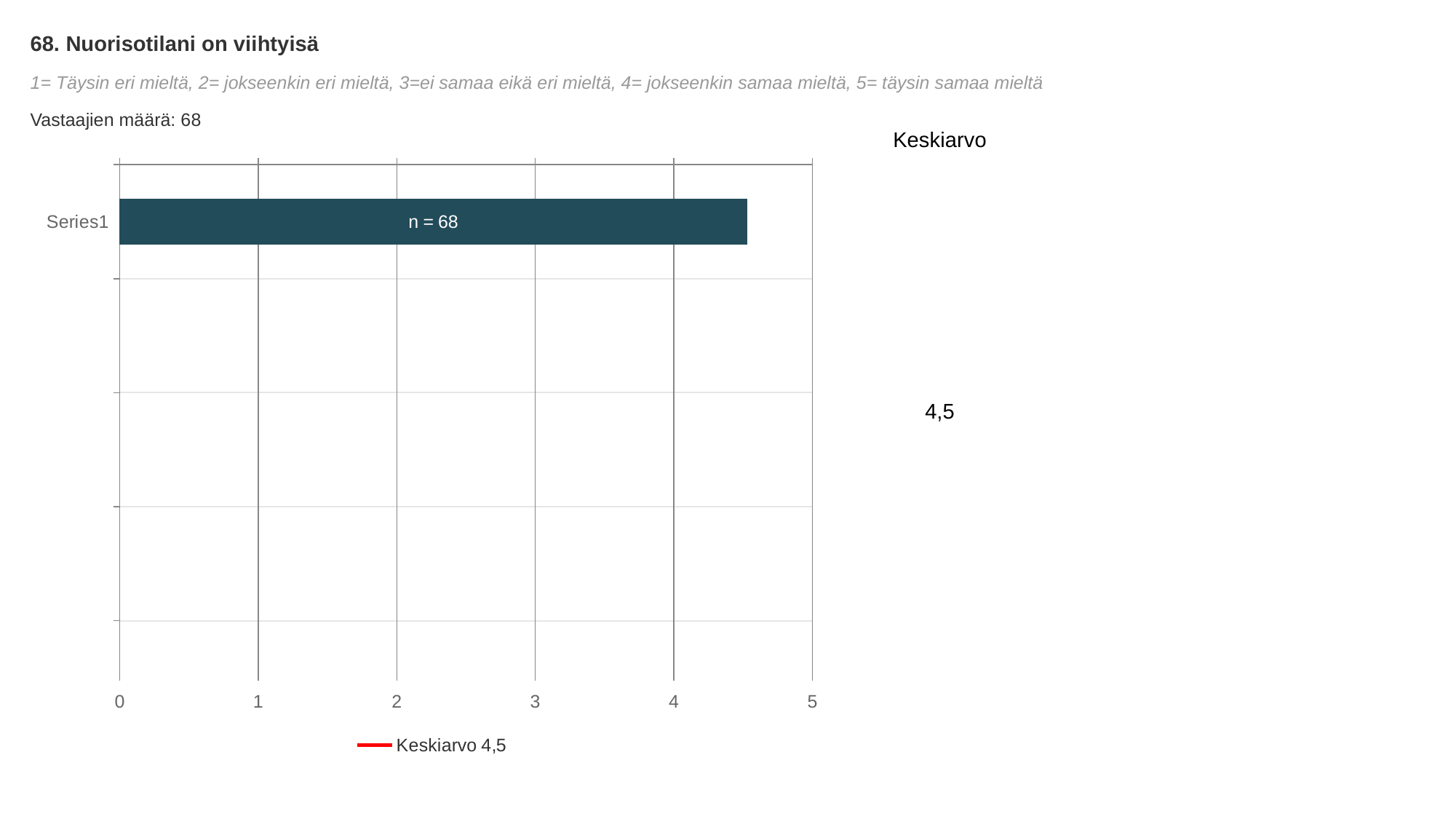
What is the Keskiarvo (mean) value shown on the slide? 4,5 How many bars are plotted in the chart? 1 Is the value of the Series1 bar greater or less than 5? less Is the value of the Series1 bar greater or less than 3? greater What is the label of the category on the y axis? Series1 What kind of chart is shown on the slide? bar chart What is the highest value shown on the x axis? 5 What is the number of respondents (Vastaajien määrä) stated on the slide? 68 What is the title of the chart? 68. Nuorisotilani on viihtyisä Is the value of the Series1 bar greater or less than 4? greater What data label is printed on the Series1 bar? n = 68